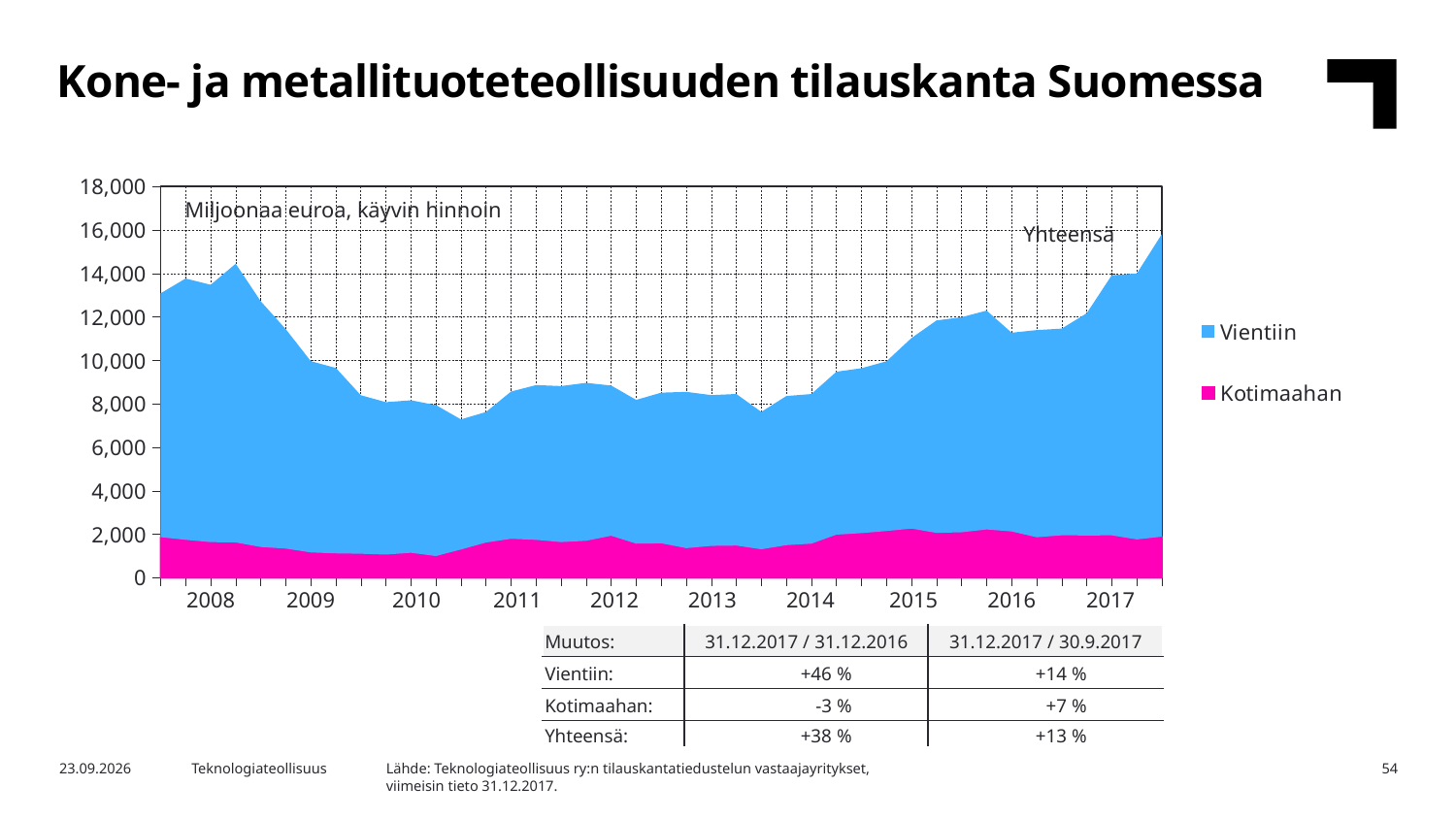
Which two series are listed in the chart legend? Vientiin and Kotimaahan Which series is larger throughout the chart, Vientiin or Kotimaahan? Vientiin What kind of chart is shown on the slide? Area chart How many years are labelled on the x axis of the chart? 10 What unit is stated in the chart for the values? Miljoonaa euroa, käyvin hinnoin Does the total order backlog rise or fall from 2016 to the end of 2017? rise Is the total order backlog (Yhteensä) during 2010 greater or less than 10,000? less Is the total order backlog (Yhteensä) at the end of 2017 greater or less than 14,000? greater How many series does the legend list? 2 Is the total order backlog at the start of 2008 greater or less than 12,000? greater Does the total order backlog rise or fall from 2008 to 2010? fall